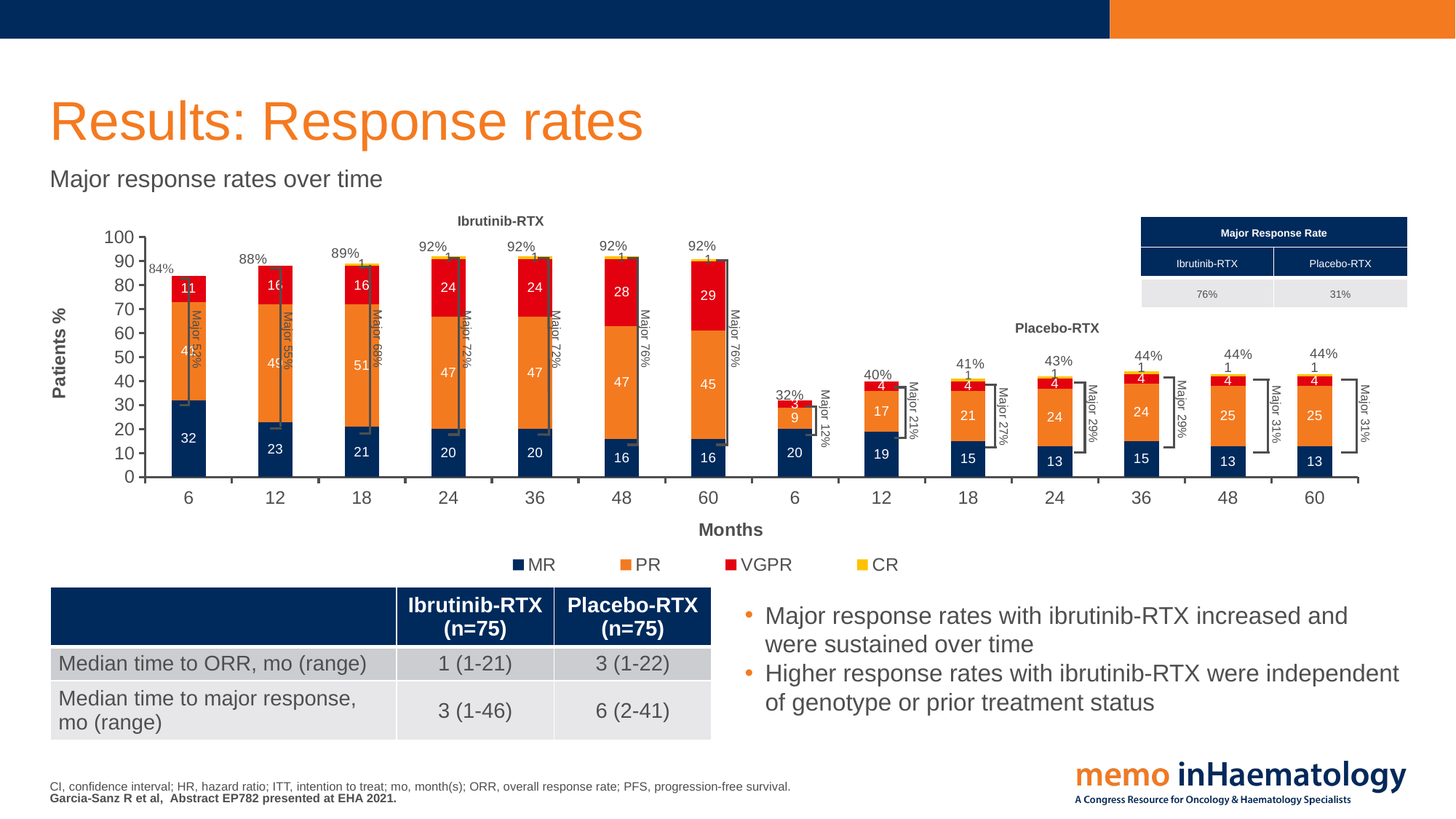
What is the Major response rate labelled for Ibrutinib-RTX at 48 months? 76% How many series does the chart legend list? 4 Do the Placebo-RTX total response rates rise or fall from 6 months to 60 months? Rise What is the total response rate labelled above the Placebo-RTX bar at 6 months? 32% How many time points are plotted for each treatment group? 7 What kind of chart is shown on the slide? Stacked bar chart What is the VGPR value for Ibrutinib-RTX at 60 months? 29 What is the MR value for Ibrutinib-RTX at 6 months? 32 At which time point is the Placebo-RTX total response rate lowest? 6 months What is the total response rate labelled above the Ibrutinib-RTX bar at 6 months? 84% Which has the larger PR value at 18 months, Ibrutinib-RTX or Placebo-RTX? Ibrutinib-RTX What is the difference between the Ibrutinib-RTX total response rate and the Placebo-RTX total response rate at 60 months? 48 percentage points